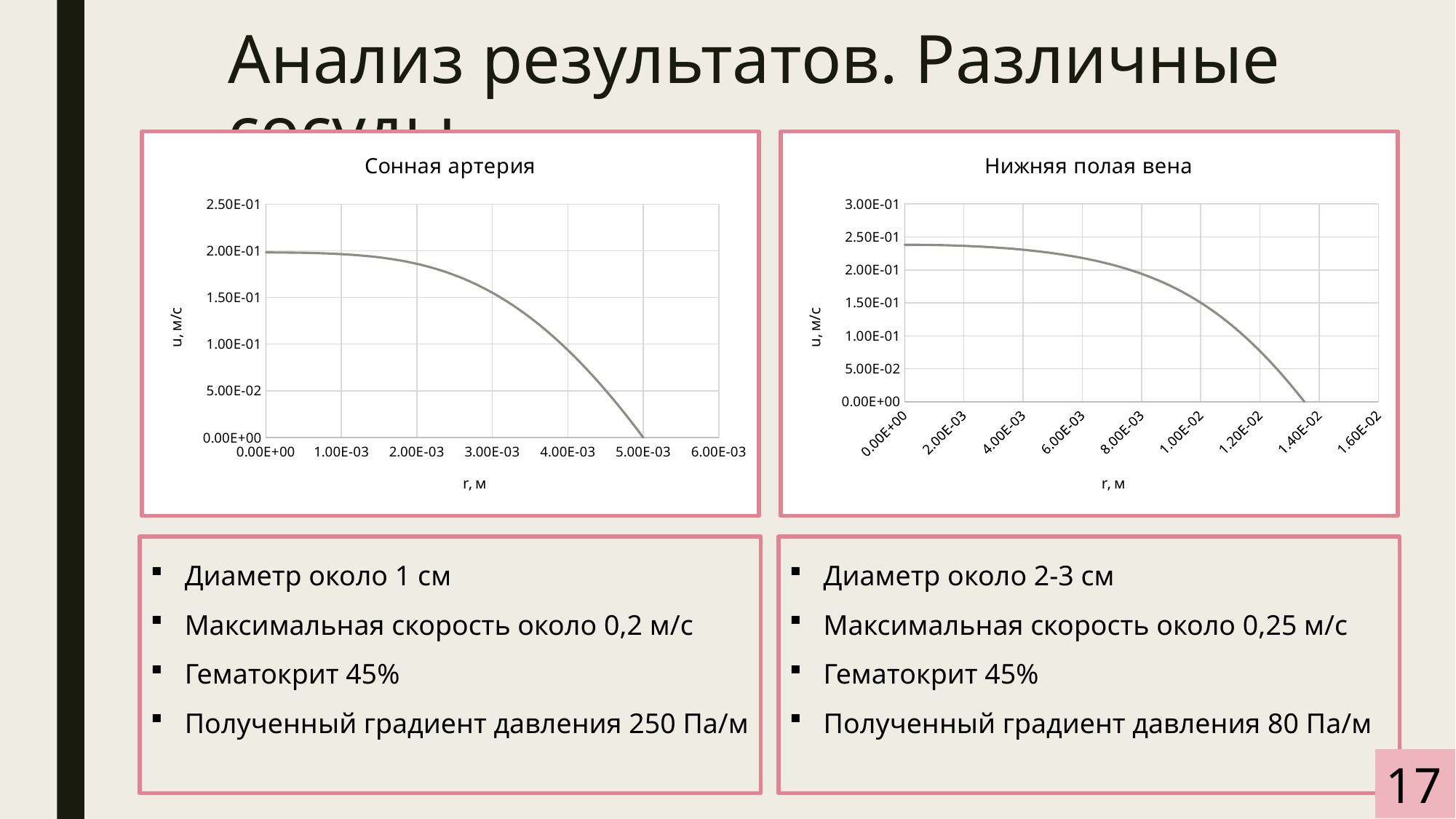
In the "Нижняя полая вена" chart, is the value of u at r = 1.20E-02 greater or less than 1.50E-01? less What kind of chart is the "Сонная артерия" chart? line chart In the "Сонная артерия" chart, does the value of u rise or fall as r increases? fall What is the title of the chart on the left side of the slide? Сонная артерия In the "Сонная артерия" chart, is the value of u at r = 4.00E-03 greater or less than 1.50E-01? less What kind of chart is the "Нижняя полая вена" chart? line chart In the "Нижняя полая вена" chart, does the value of u rise or fall as r increases? fall In the "Нижняя полая вена" chart, is the value of u at r = 0.00E+00 greater or less than 2.00E-01? greater What is the label of the vertical axis in the "Нижняя полая вена" chart? u, м/с